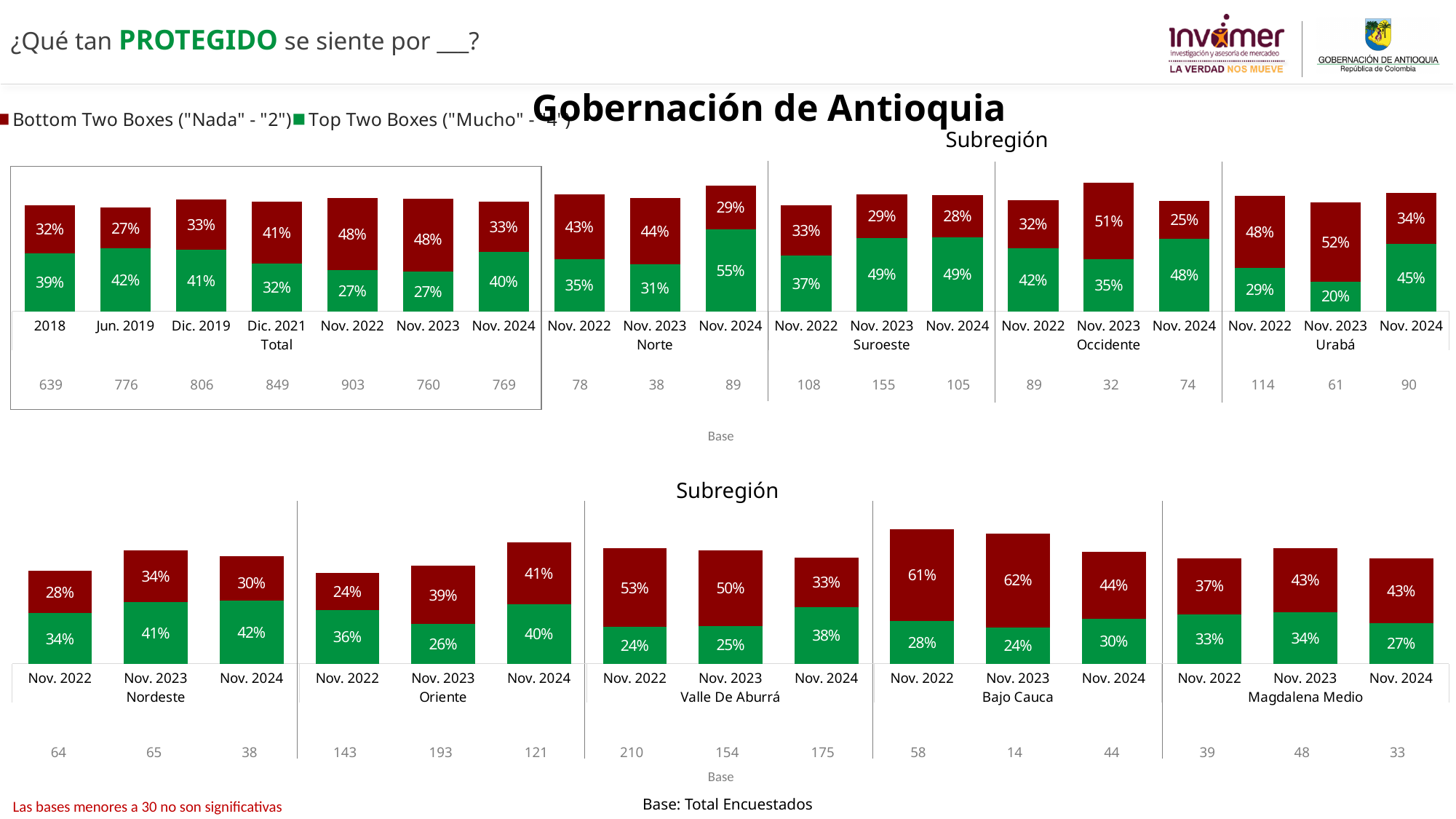
In the top chart, what is the Top Two Boxes value for Urabá in Nov. 2023? 20% In the bottom chart, what is the Top Two Boxes value for Valle De Aburrá in Nov. 2024? 38% In the top chart, which Total period has the highest Top Two Boxes value? Jun. 2019 In the bottom chart, which Nov. 2024 subregion has the lowest Top Two Boxes value? Magdalena Medio In the bottom chart, what is the Bottom Two Boxes value for Bajo Cauca in Nov. 2023? 62% In the top chart, what is the combined total of the Bottom Two Boxes and Top Two Boxes values for Suroeste in Nov. 2022? 70% In the top chart, what is the Top Two Boxes value for Total in Nov. 2024? 40% In the top chart, what is the Bottom Two Boxes value for Occidente in Nov. 2023? 51% How many series does the legend list? 2 What kind of chart is shown on the slide? Stacked bar chart In the bottom chart, which is larger for Oriente in Nov. 2023: the Bottom Two Boxes value or the Top Two Boxes value? Bottom Two Boxes In the top chart, what is the difference between the Bottom Two Boxes and Top Two Boxes values for Norte in Nov. 2024? 26%